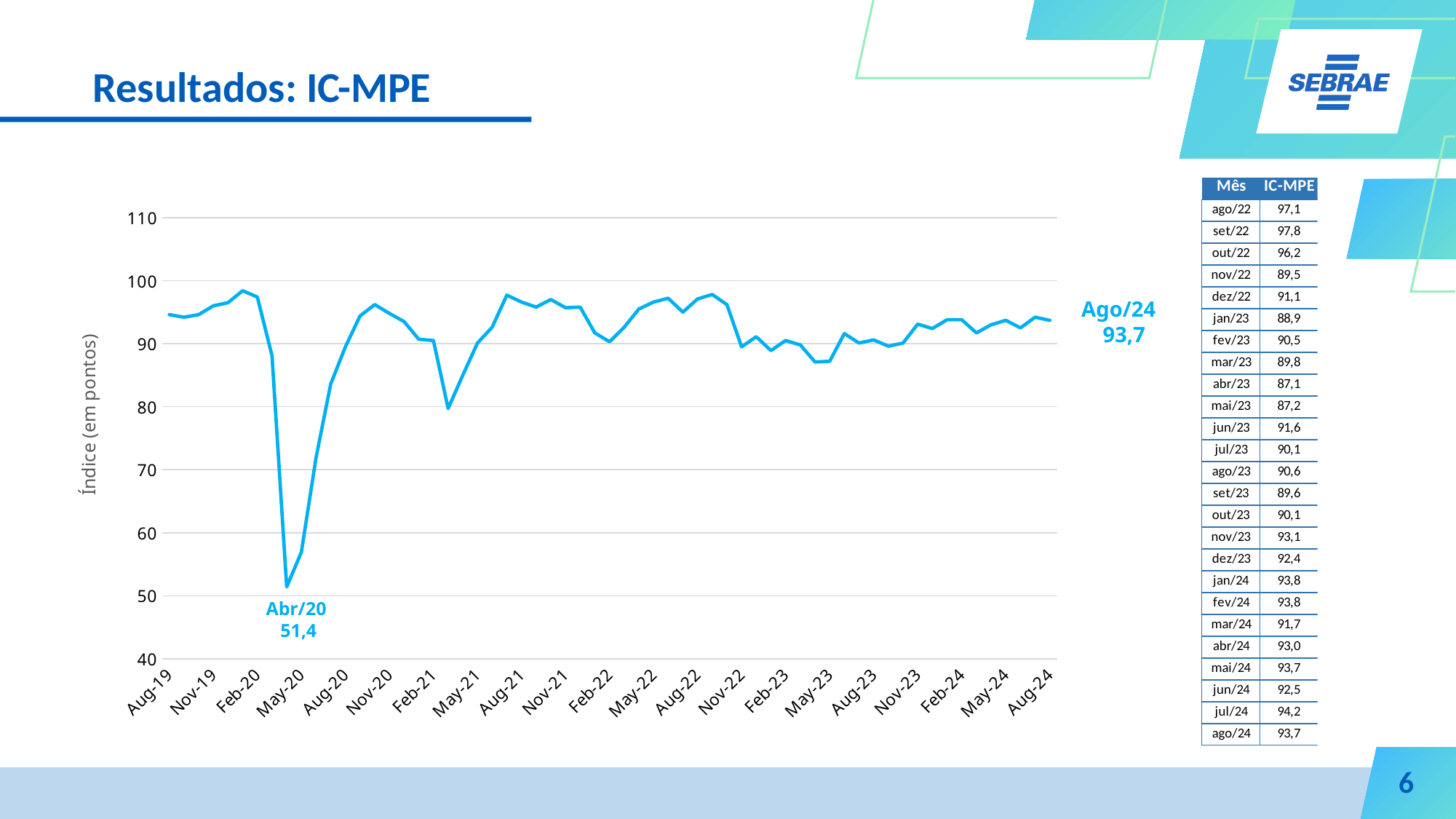
Is the value for Aug-19 greater or less than 90? greater What is the difference between the labelled values for Ago/24 and Abr/20? 42,3 According to the table beside the chart, what is the IC-MPE value for jul/24? 94,2 What is the value of the IC-MPE index at Ago/24, as labelled on the chart? 93,7 Which is larger, the labelled value for Ago/24 or for Abr/20? Ago/24 What is the label of the vertical axis? Índice (em pontos) At which month does the line reach its lowest point? Abr/20 Does the line rise or fall between Feb-20 and Abr/20? falls What is the value of the IC-MPE index at Abr/20, as labelled on the chart? 51,4 What kind of chart is shown on the slide? Line chart Is the value for Feb-20 greater or less than 90? greater Is the value for Aug-22 greater or less than 90? greater